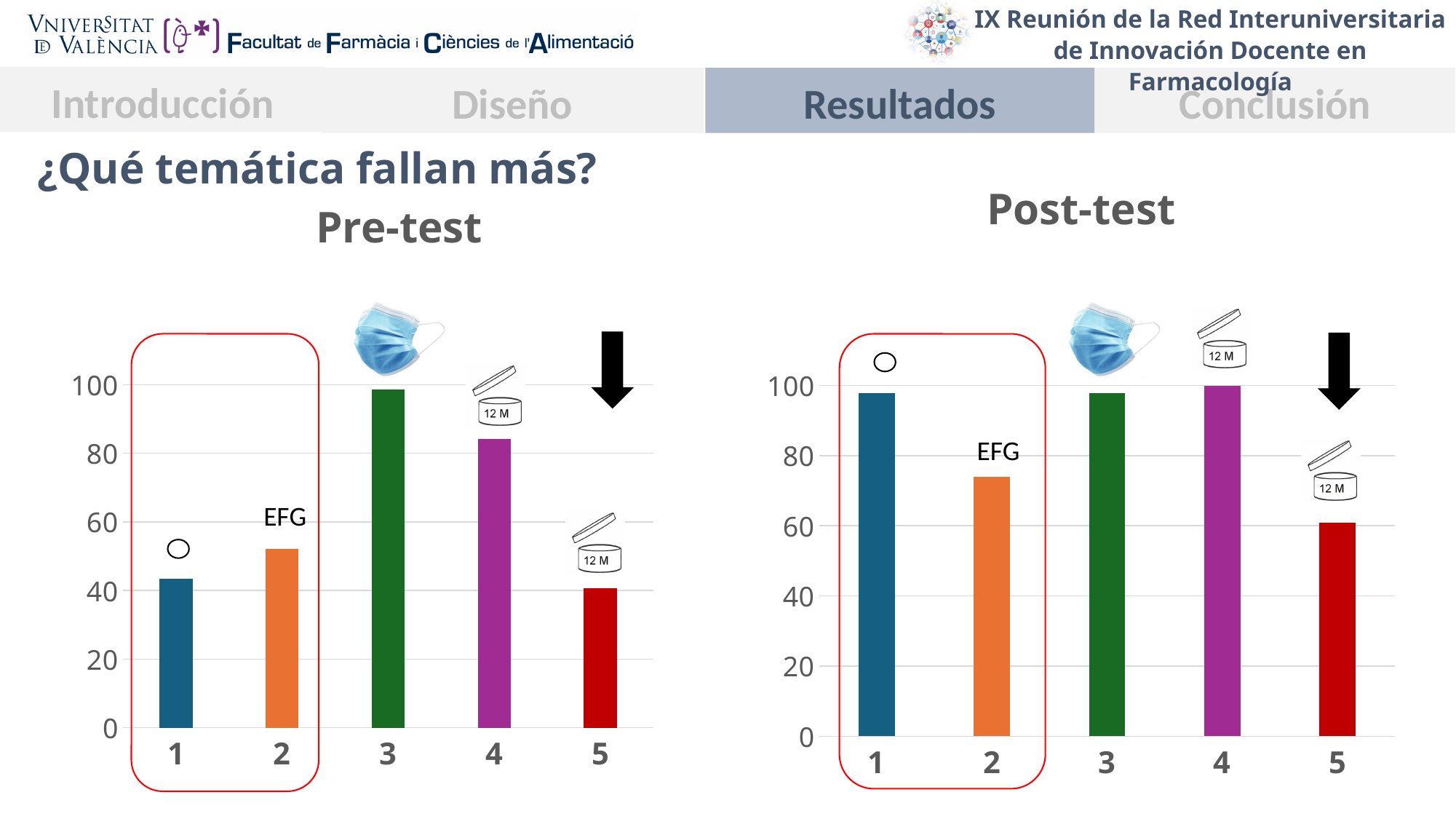
In the Pre-test chart, is the value for category 1 greater or less than 60? less In the Post-test chart, which category has the lowest bar? 5 What kind of chart is the Pre-test chart? bar chart In the Pre-test chart, what colour is the bar for category 3? green In the Post-test chart, is the value for category 5 greater or less than 80? less In the Pre-test chart, which category has the highest bar? 3 In the Pre-test chart, which is larger, the value for category 4 or category 5? 4 What is the title of the chart on the right side of the slide? Post-test In the Pre-test chart, is the value for category 3 greater or less than 80? greater In the Post-test chart, which is larger, the value for category 1 or category 2? 1 How many categories are shown on the Post-test chart? 5